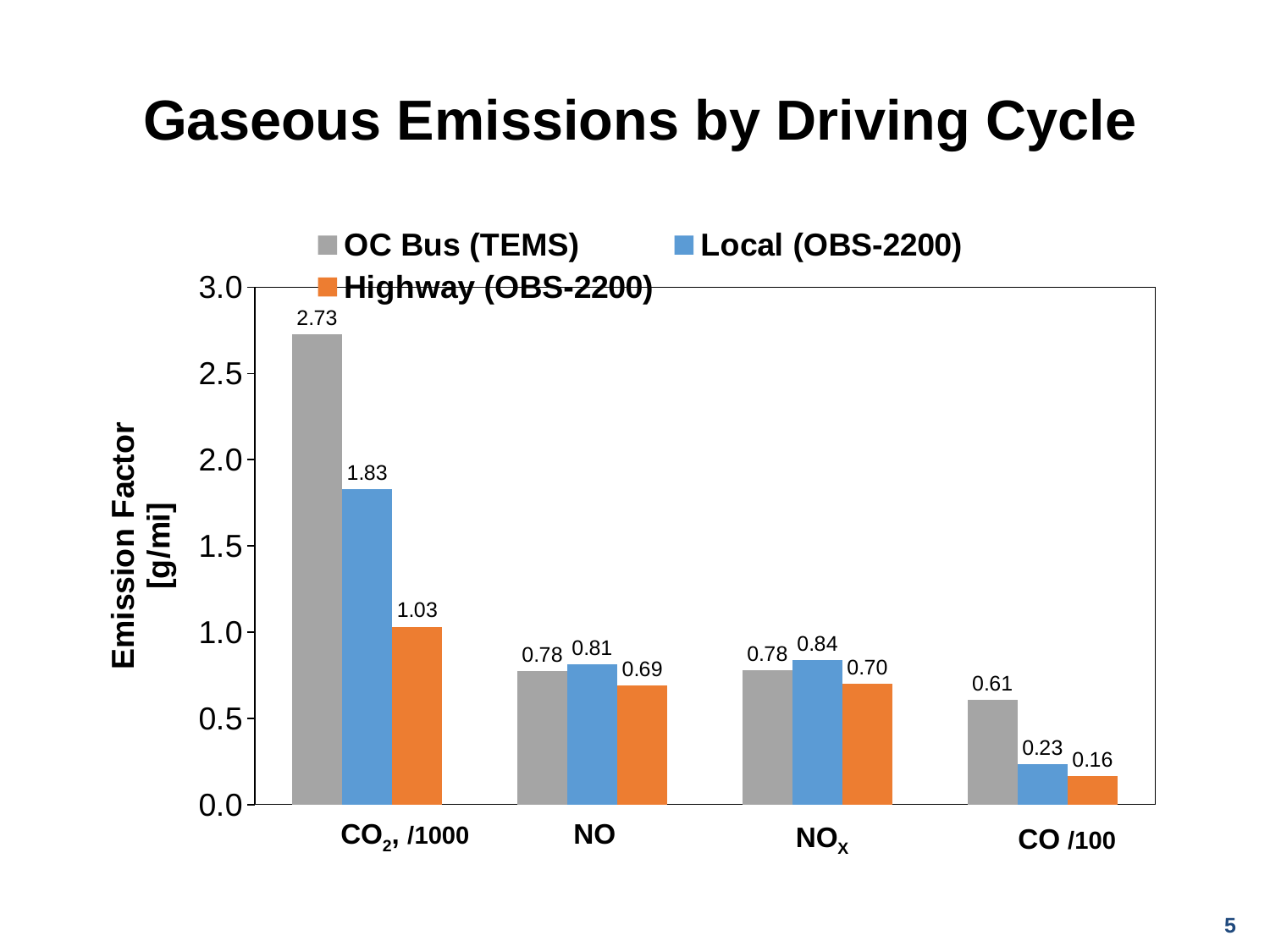
What is the OC Bus (TEMS) emission factor for CO2, /1000? 2.73 What is the difference between the OC Bus (TEMS) and Highway (OBS-2200) values for CO2, /1000? 1.70 What is the Local (OBS-2200) emission factor for NOx? 0.84 What is the Highway (OBS-2200) emission factor for CO /100? 0.16 Is the Local (OBS-2200) value for CO2, /1000 greater or less than 1.5? greater How many categories are shown on the x axis? 4 Which is larger for NO: the OC Bus (TEMS) value or the Local (OBS-2200) value? Local (OBS-2200) Which category has the lowest Highway (OBS-2200) value? CO /100 Which category has the highest OC Bus (TEMS) value? CO2, /1000 How many series does the legend list? 3 What is the difference between the Local (OBS-2200) and Highway (OBS-2200) values for CO /100? 0.07 What type of chart is shown on the slide? Bar chart